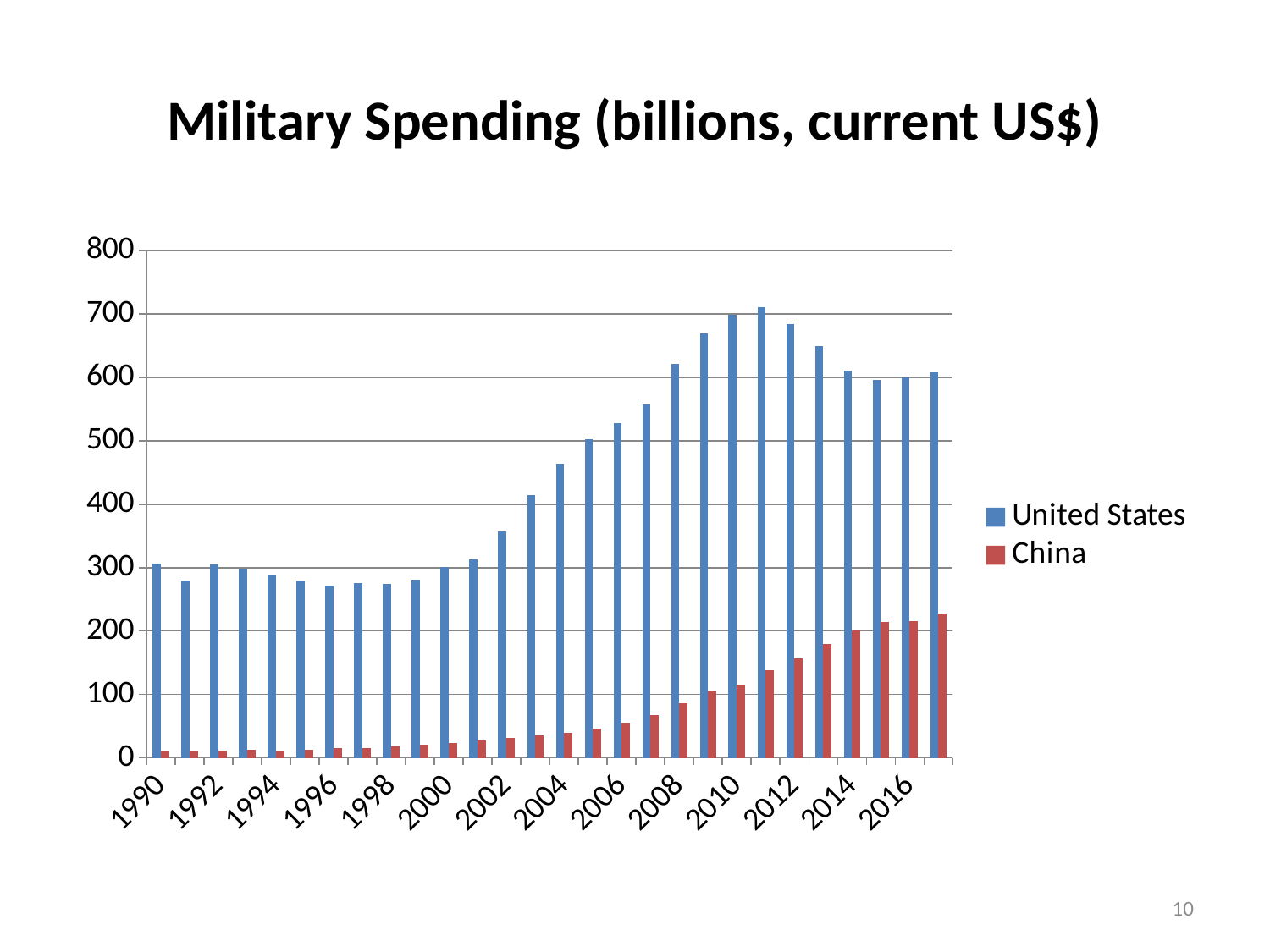
In which year is United States military spending highest? 2011 What is the title of the chart? Military Spending (billions, current US$) Is the value for China in 2012 greater or less than 100? greater Is the value for China in 2008 greater or less than 100? less Which is larger: United States spending in 2010 or United States spending in 2000? 2010 Is the value for the United States in 2010 greater or less than 600? greater Which series is shown in red? China How many series does the legend list? 2 Does China's military spending generally rise or fall from 1990 to 2016? rise What kind of chart is shown on the slide? bar chart